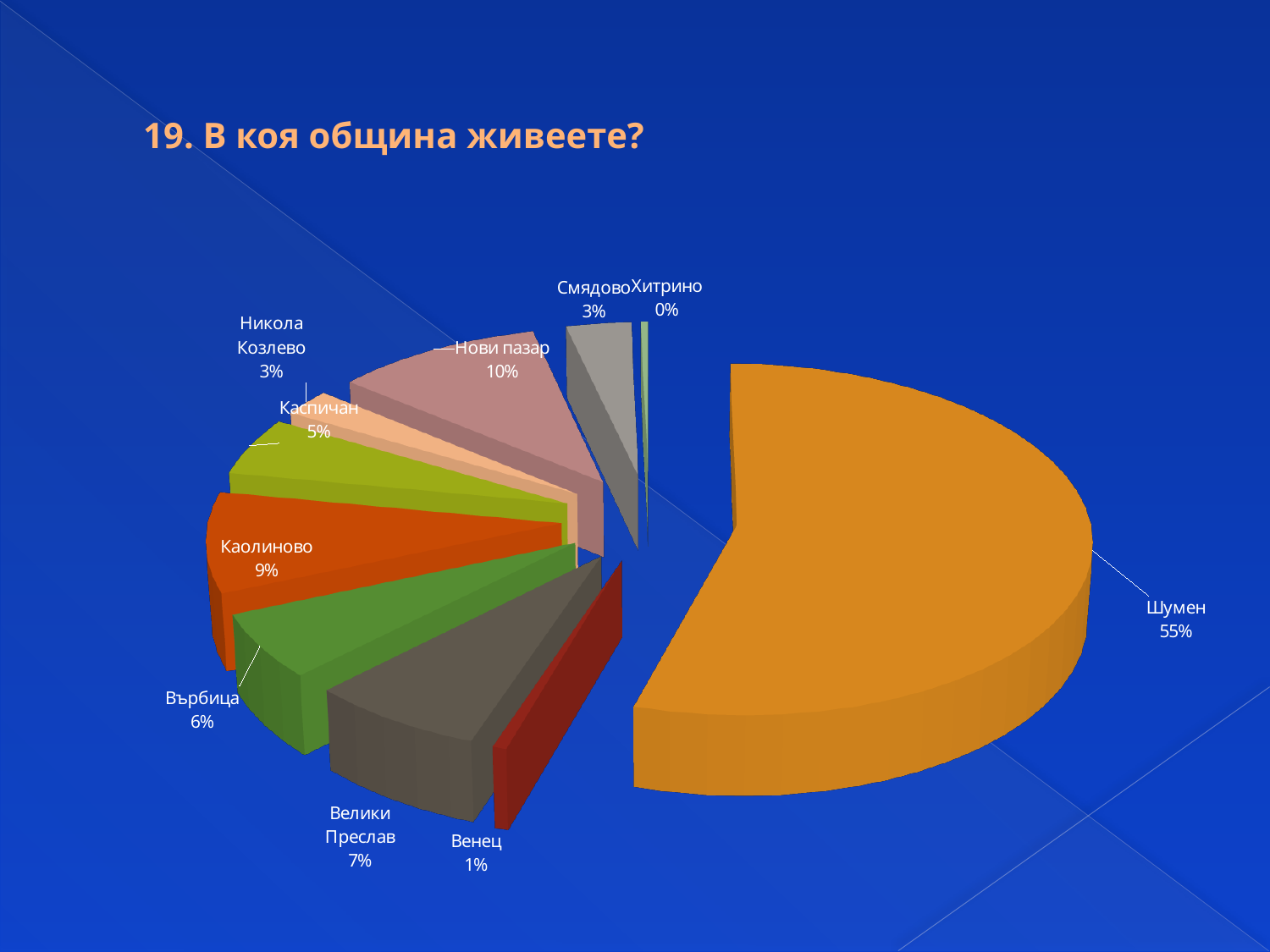
What share of the pie does Шумен have? 55% Which is larger, the share for Върбица or the share for Каолиново? Каолиново How many municipalities (slices) are shown in the pie chart? 10 Which municipality has the smallest slice of the pie? Хитрино What kind of chart is shown on the slide? pie chart Which municipality has the largest slice of the pie? Шумен What is the value shown for Каолиново? 9% What is the value shown for Велики Преслав? 7% What is the title of the chart? 19. В коя община живеете? What is the difference between the shares of Нови пазар and Каспичан? 5% What is the value shown for Хитрино? 0% What share of the pie does Нови пазар have? 10%